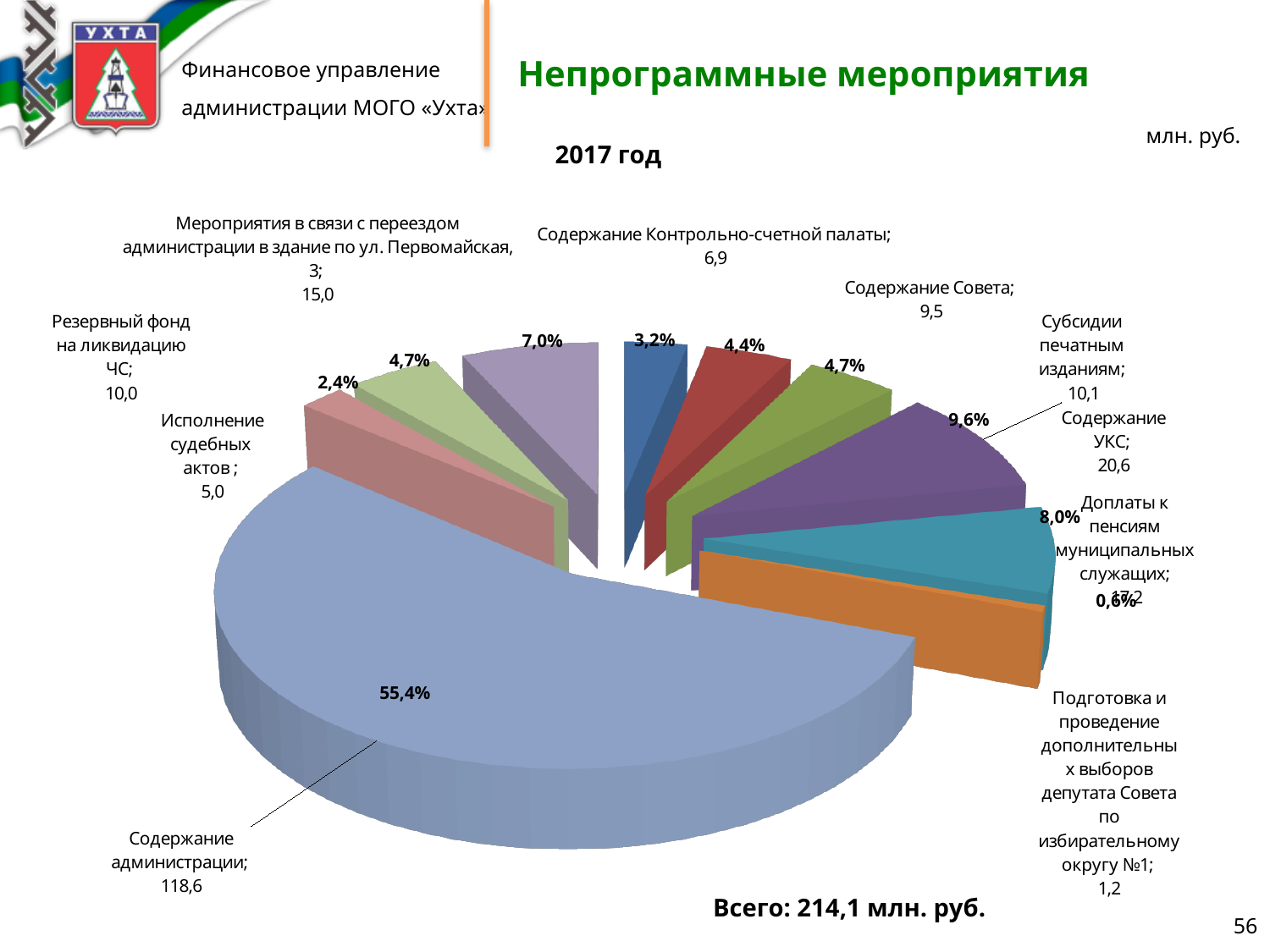
What is the difference between "Содержание УКС" and "Содержание Совета"? 11,1 How many categories does the pie chart have? 10 What share of the pie does "Содержание УКС" take? 9,6% What total is stated below the chart? 214,1 млн. руб. What is the value for "Содержание администрации"? 118,6 What share of the pie does "Содержание администрации" take? 55,4% What is the value for "Содержание УКС"? 20,6 Which category has the largest value? Содержание администрации Which is larger: "Резервный фонд на ликвидацию ЧС" or "Исполнение судебных актов"? Резервный фонд на ликвидацию ЧС Which category has the smallest value? Подготовка и проведение дополнительных выборов депутата Совета по избирательному округу №1 What type of chart is shown on the slide? pie chart What is the value for "Доплаты к пенсиям муниципальных служащих"? 17,2